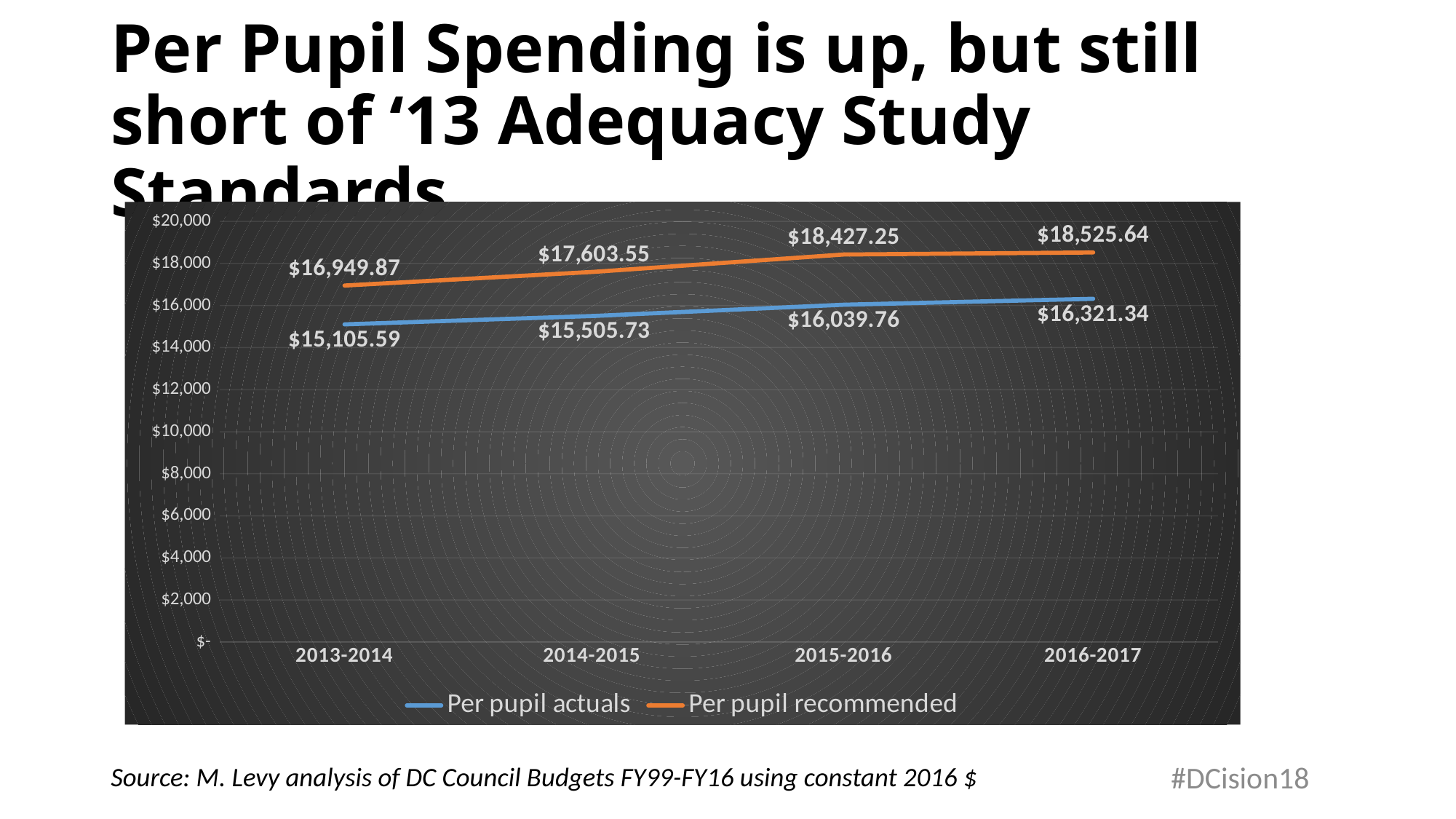
What is the difference between Per pupil recommended and Per pupil actuals in 2016-2017? $2,204.30 How many school years are shown on the x axis? 4 By how much did Per pupil actuals increase from 2013-2014 to 2016-2017? $1,215.75 What is the value for Per pupil actuals in 2016-2017? $16,321.34 Which is larger in 2014-2015: Per pupil actuals or Per pupil recommended? Per pupil recommended What is the value for Per pupil actuals in 2013-2014? $15,105.59 How many series does the legend list? 2 In which year is Per pupil actuals lowest? 2013-2014 What is the value for Per pupil recommended in 2014-2015? $17,603.55 In which year is Per pupil recommended highest? 2016-2017 What kind of chart is shown on the slide? Line chart What is the value for Per pupil recommended in 2015-2016? $18,427.25